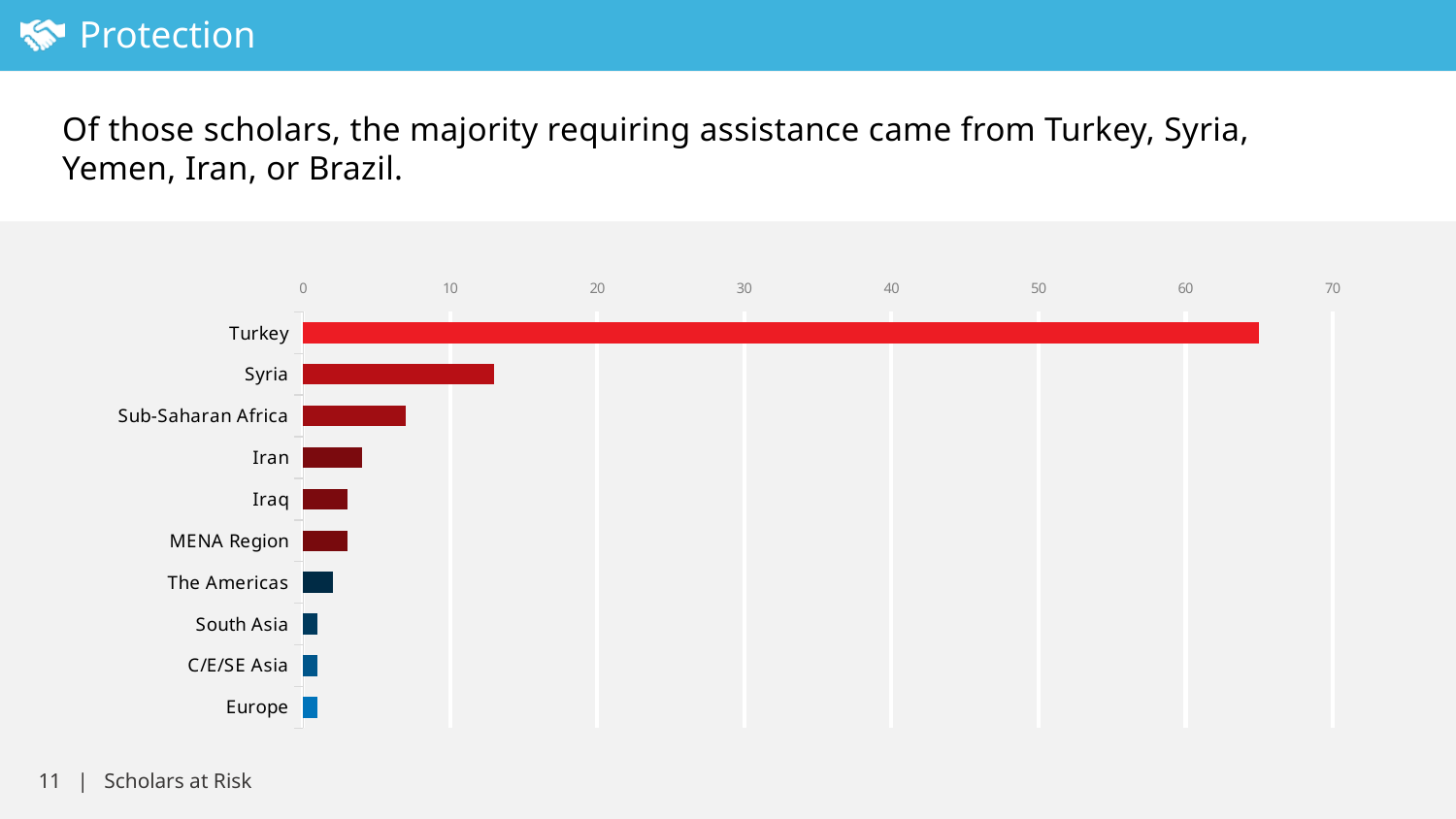
What kind of chart is shown on the slide? bar chart Is the value for Turkey greater or less than 60? greater Which has a larger value, Syria or Sub-Saharan Africa? Syria Which has a larger value, Turkey or Syria? Turkey Which has a larger value, Sub-Saharan Africa or The Americas? Sub-Saharan Africa Which category is listed at the top of the chart? Turkey Is the value for Syria greater or less than 10? greater Is the value for Iran greater or less than 10? less How many categories are plotted in the chart? 10 Which category has the highest value in the chart? Turkey